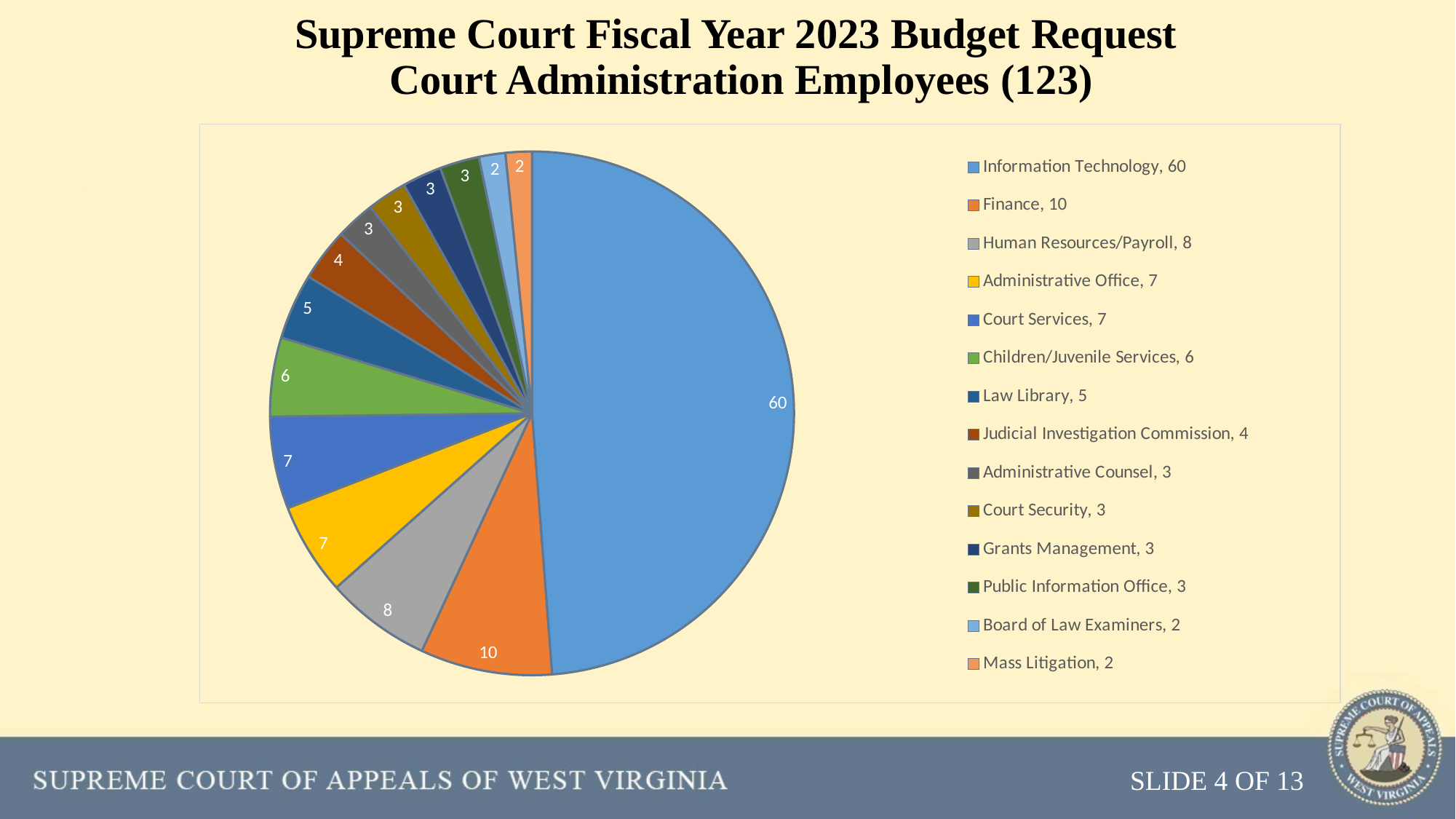
What is the total number of Court Administration employees shown in the chart? 123 What type of chart is shown on the slide? pie chart How many employees are in the Law Library? 5 How many employees are in Mass Litigation? 2 How many employees are in Information Technology? 60 How many employees are in Finance? 10 Which category has the largest slice of the pie? Information Technology Which has more employees, Children/Juvenile Services or Judicial Investigation Commission? Children/Juvenile Services What is the difference between the number of Information Technology employees and Finance employees? 50 What is the title of the slide containing the chart? Supreme Court Fiscal Year 2023 Budget Request Court Administration Employees (123) How many employees are in Human Resources/Payroll? 8 How many categories does the pie chart show? 14